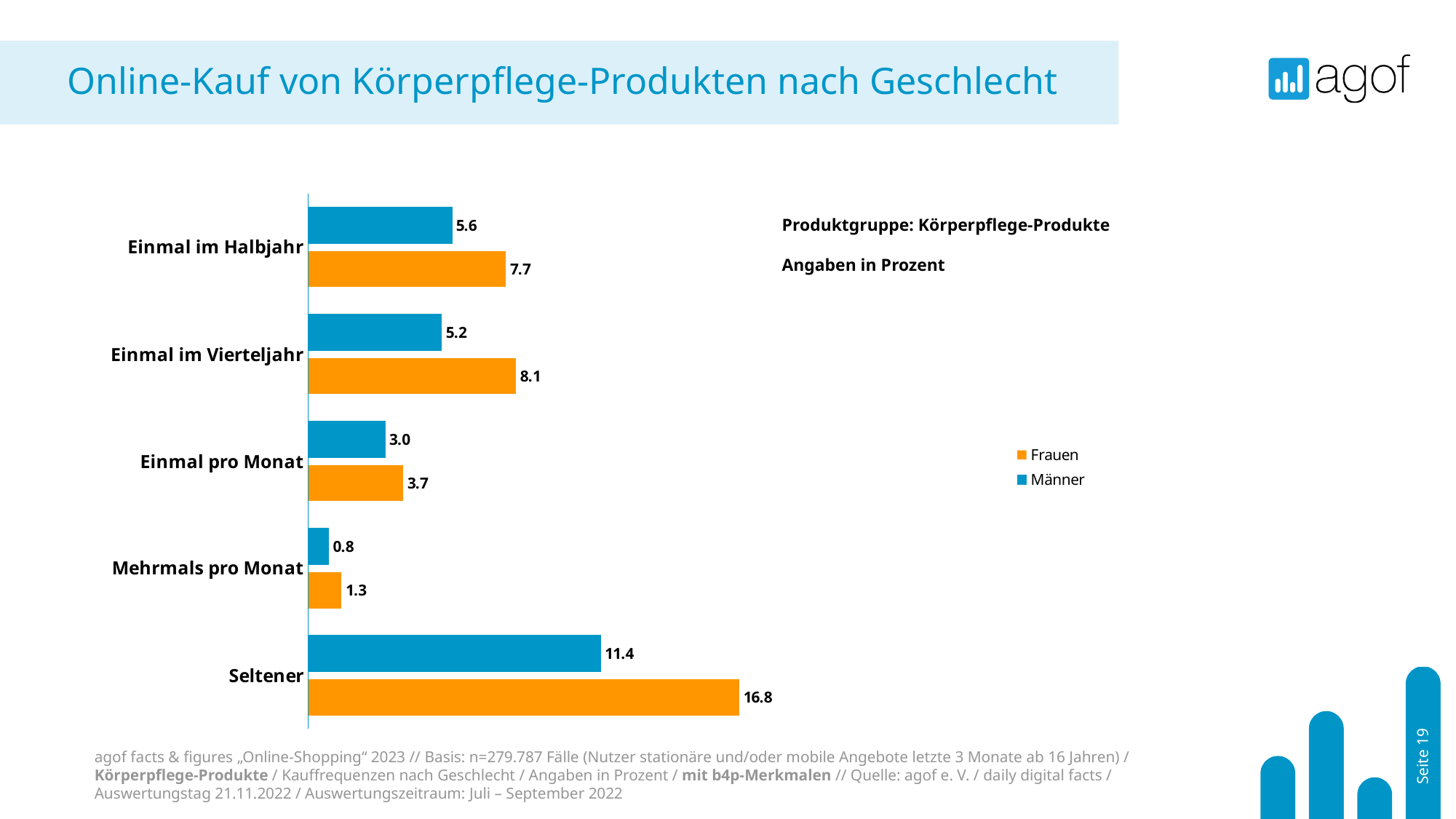
Which category has the lowest value for Frauen? Mehrmals pro Monat What is the value for Männer in the category Einmal im Vierteljahr? 5.2 How many series does the legend list? 2 What is the value for Frauen in the category Mehrmals pro Monat? 1.3 How many categories are shown on the y axis of the chart? 5 What is the difference between the Frauen and Männer values for Seltener? 5.4 Which category has the highest value for Männer? Seltener What is the value for Frauen in the category Seltener? 16.8 What is the difference between the Frauen values for Einmal im Vierteljahr and Einmal im Halbjahr? 0.4 Which is larger in the category Einmal pro Monat: the value for Frauen or for Männer? Frauen Which colour represents the Männer series in the chart? Blue What kind of chart is shown on the slide? Bar chart